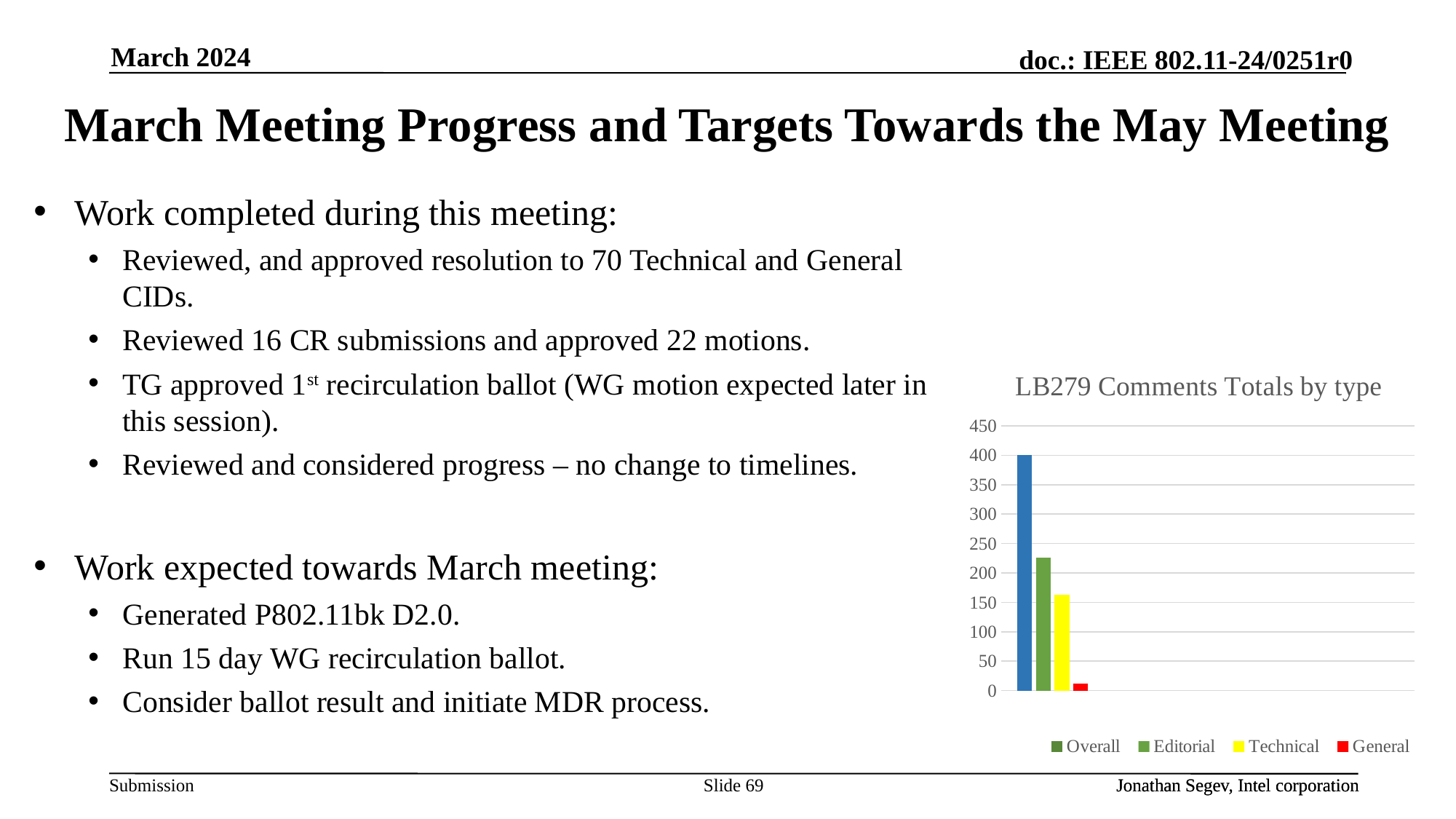
What colour is the Technical bar in the chart? yellow How many series does the chart's legend list? 4 Which is larger, the value for Editorial or the value for Technical? Editorial Which series has the highest value in the chart? Overall Is the value for Editorial greater or less than 200? greater Is the value for Technical greater or less than 200? less What is the title of the chart on the slide? LB279 Comments Totals by type Is the value for General greater or less than 50? less What kind of chart is shown on the slide? bar chart Which is larger, the value for Technical or the value for General? Technical Which series has the lowest value in the chart? General